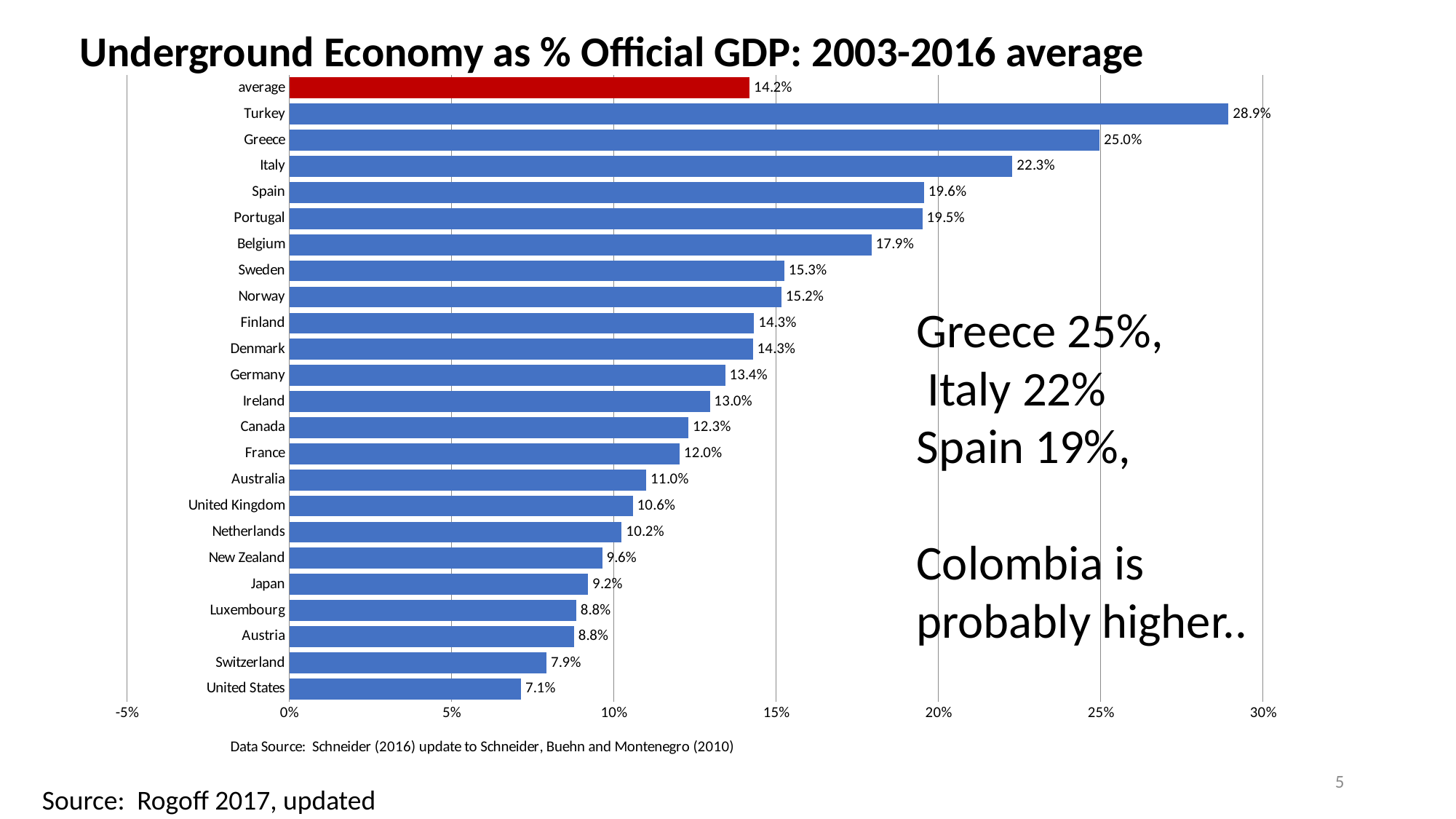
How many bars are plotted in the chart, including the average bar? 24 Is the value for Spain greater or less than 15%? greater Which has a larger value, Belgium or Sweden? Belgium Which country has the lowest underground economy as a percentage of official GDP? United States What is the value shown for the average bar? 14.2% What is the difference between the values for Turkey and the United States? 21.8% Which country has the highest underground economy as a percentage of official GDP? Turkey What is the title of the chart? Underground Economy as % Official GDP: 2003-2016 average What kind of chart is shown on the slide? Bar chart What is the difference between the values for Greece and Italy? 2.7% What is the value for Turkey? 28.9% What is the value for Germany? 13.4%